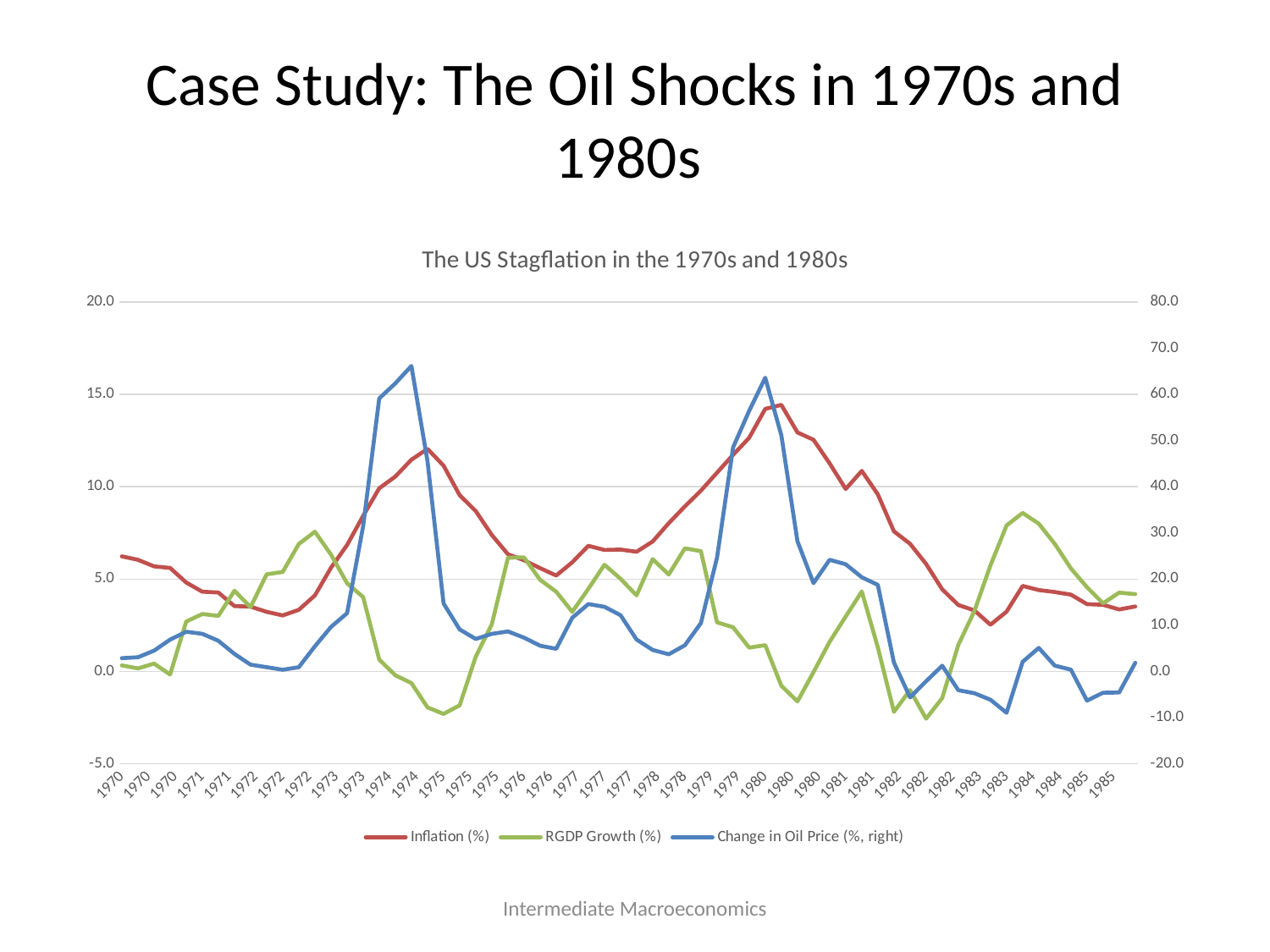
Is the peak value of RGDP Growth (%) around 1984 greater or less than 5.0? greater Does Change in Oil Price (%, right) rise or fall between 1980 and 1982? fall Which is higher: the Inflation (%) peak around 1974 or the Inflation (%) peak around 1980? the peak around 1980 How many series does the legend list? 3 What is the title of the chart? The US Stagflation in the 1970s and 1980s Is the value of Inflation (%) at the end of 1985 greater or less than 5.0? less Does Inflation (%) rise or fall between 1976 and 1980? rise Of the two series plotted on the left axis, which reaches the higher maximum value? Inflation (%) What kind of chart is shown on the slide? line chart Is the peak value of Inflation (%) around 1980 greater or less than 10.0? greater Which series is plotted against the right-hand axis? Change in Oil Price (%, right)